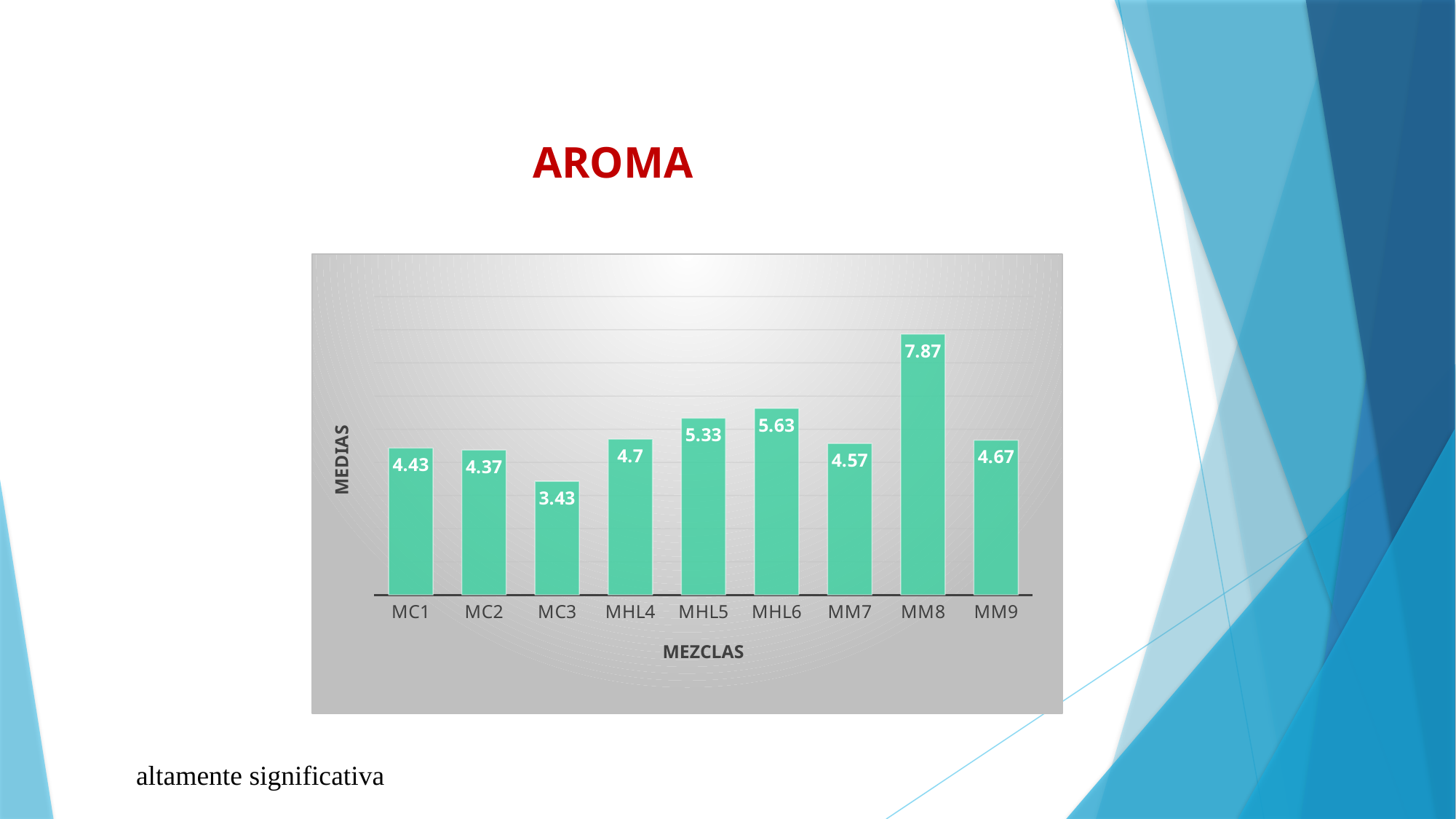
Which category has the highest value? MM8 What is the title of the chart? AROMA What is the value for MM8? 7.87 What is the value for MM9? 4.67 What is the difference between the values for MHL6 and MHL5? 0.3 What is the value for MC3? 3.43 Which is larger, the value for MHL4 or the value for MM7? MHL4 How many categories are shown on the x axis? 9 What kind of chart is shown on the slide? Bar chart What is the difference between the values for MM8 and MC3? 4.44 What is the value for MHL5? 5.33 Which category has the lowest value? MC3